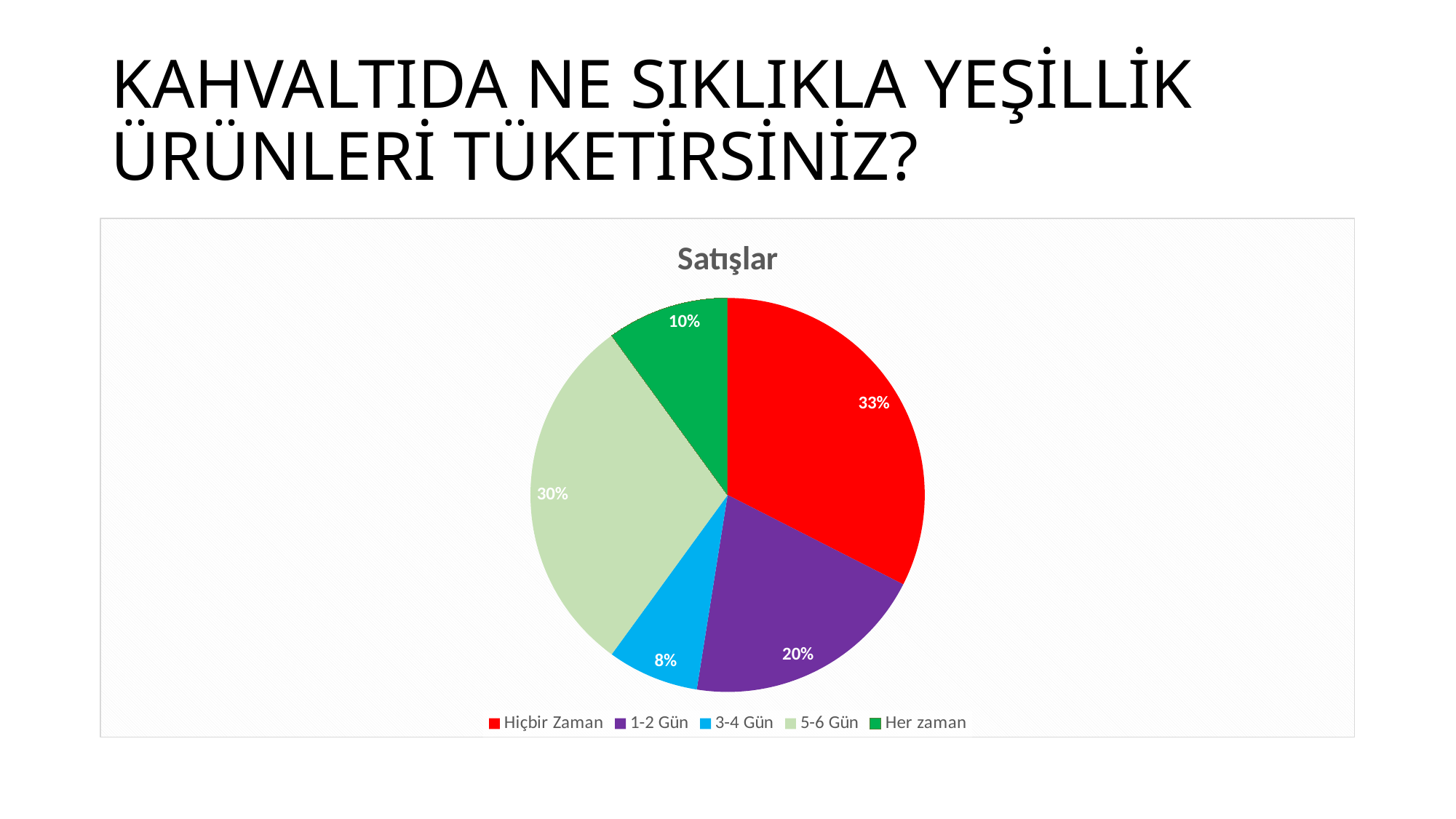
Which category has the smallest slice? 3-4 Gün What share of the pie does Hiçbir Zaman have? 33% What kind of chart is shown on the slide? pie chart Which category has the largest slice? Hiçbir Zaman Which is larger, the 5-6 Gün slice or the Her zaman slice? 5-6 Gün What is the chart's title? Satışlar What is the difference between the Hiçbir Zaman and 1-2 Gün slices? 13% What is the value for Her zaman? 10% How many categories does the legend list? 5 What is the value for 1-2 Gün? 20% What is the value for 3-4 Gün? 8% What share of the pie does 5-6 Gün have? 30%